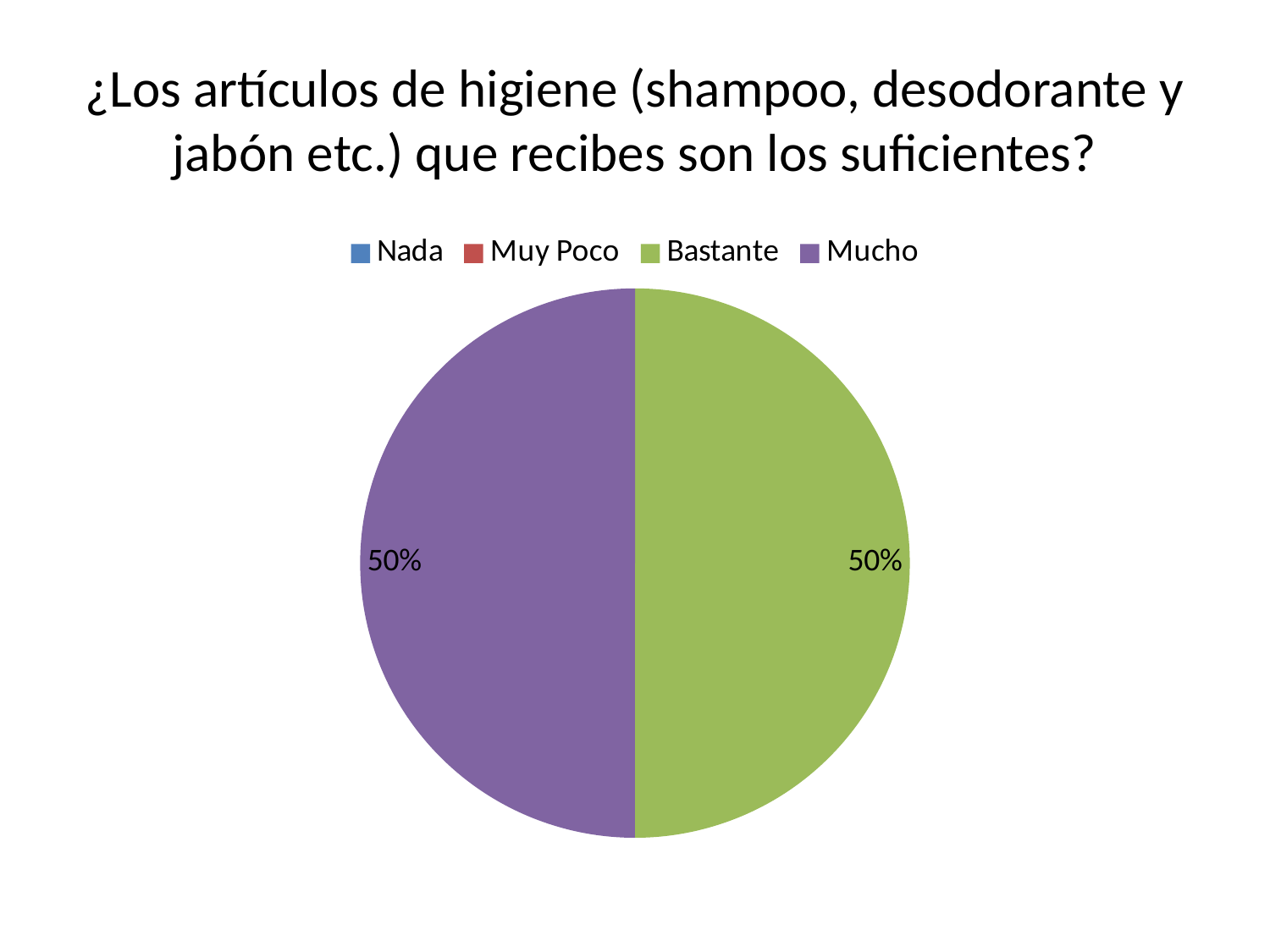
What share of the pie does the Bastante slice represent? 50% What share of the pie does the Mucho slice represent? 50% How many slices are visible in the pie chart? 2 What colour is the Mucho slice? Purple What colour is the Bastante slice? Green Which legend entries have no visible slice in the pie? Nada and Muy Poco What kind of chart is shown on the slide? Pie chart Are the shares for Bastante and Mucho equal? Yes, both are 50% How many entries does the legend list? 4